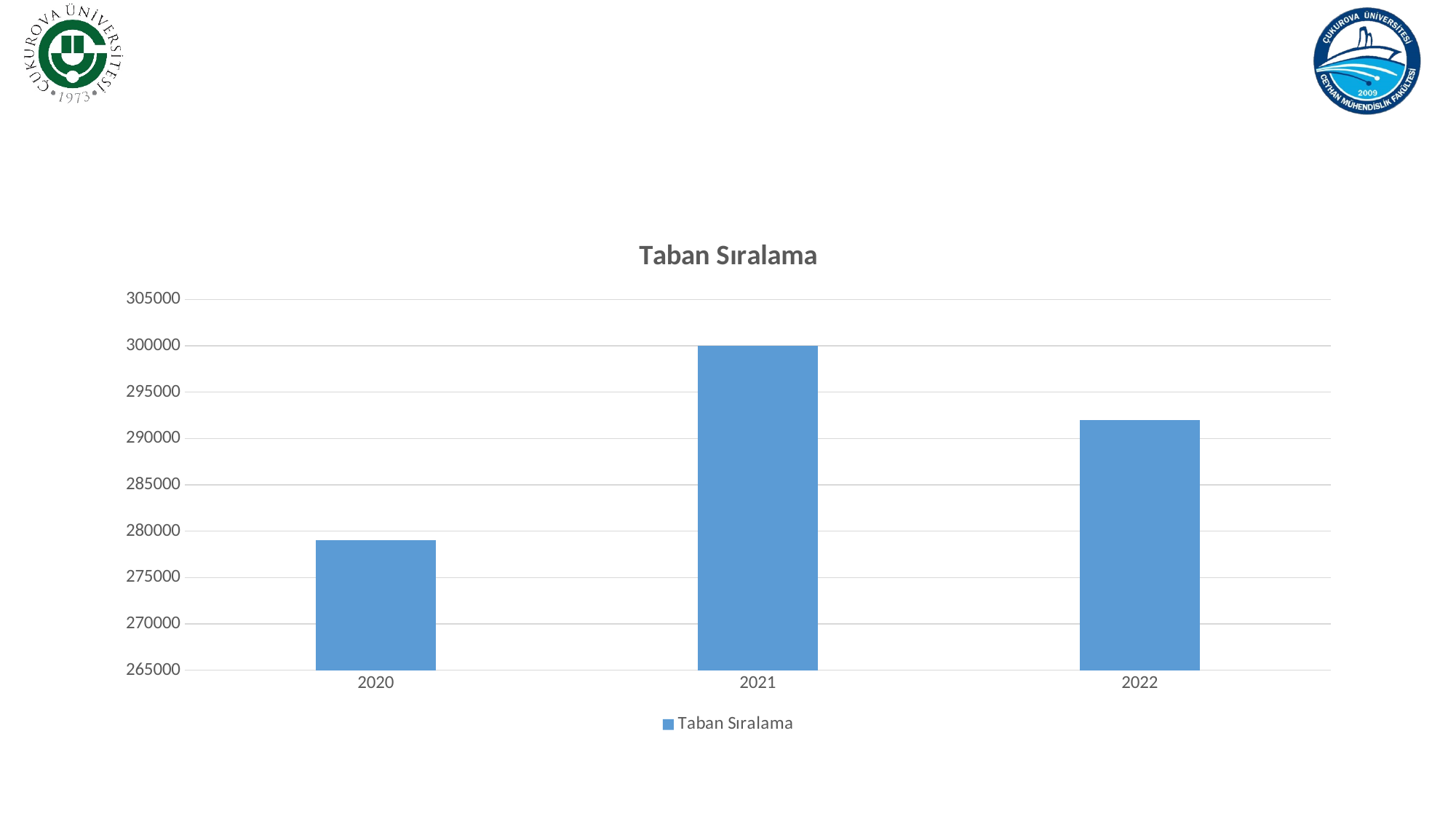
Which is larger, the value for 2022 or the value for 2020? 2022 How many series does the legend list? 1 How many bars (categories) does the chart show? 3 What is the value for 2021? 300000 Which year has the highest value? 2021 Which year has the lowest value? 2020 Is the value for 2022 greater or less than 290000? greater What kind of chart is shown on the slide? bar chart Is the value for 2020 greater or less than 280000? less Does the value rise or fall from 2020 to 2021? rise What is the name of the series shown in the legend? Taban Sıralama What is the title of the chart? Taban Sıralama